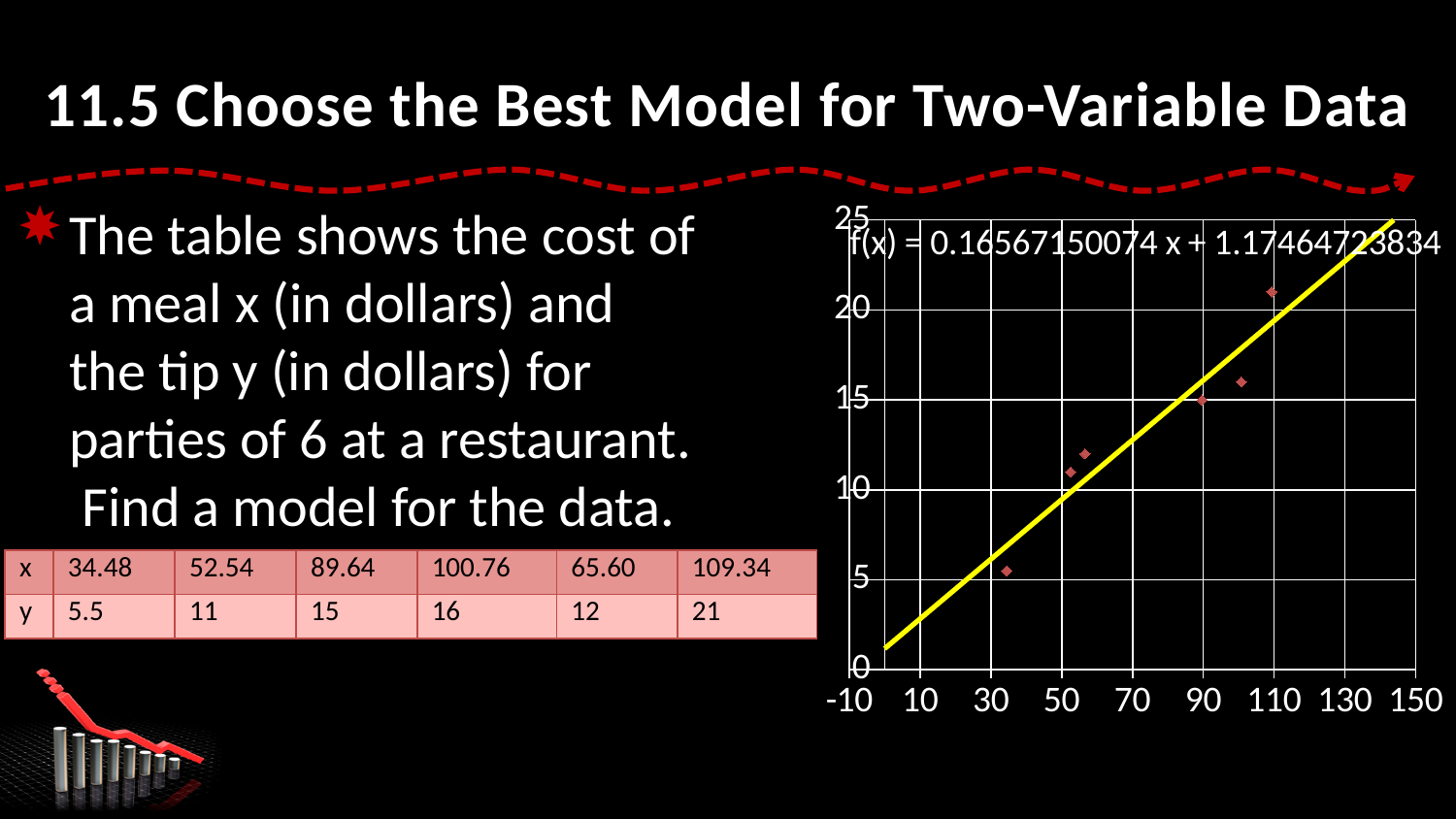
What is the slope of the trendline equation shown on the chart? 0.16567150074 What is the y-intercept of the trendline equation shown on the chart? 1.17464723834 How many data points are plotted on the scatter chart? 6 Is the y value of the point plotted near x = 110 greater or less than 10? greater What is the largest value labelled on the x axis of the chart? 150 Is the y value of the point plotted near x = 90 greater or less than 20? less Is the y value of the point plotted near x = 34 greater or less than 10? less Do the plotted points generally rise or fall as x increases along the x axis? rise Which plotted point has the highest y value: the one near x = 110 or the one near x = 34? the one near x = 110 What kind of chart is shown on the right of the slide? scatter chart What equation is displayed for the trendline on the chart? f(x) = 0.16567150074 x + 1.17464723834 According to the table on the slide, what is the tip y when the meal cost x is 109.34? 21